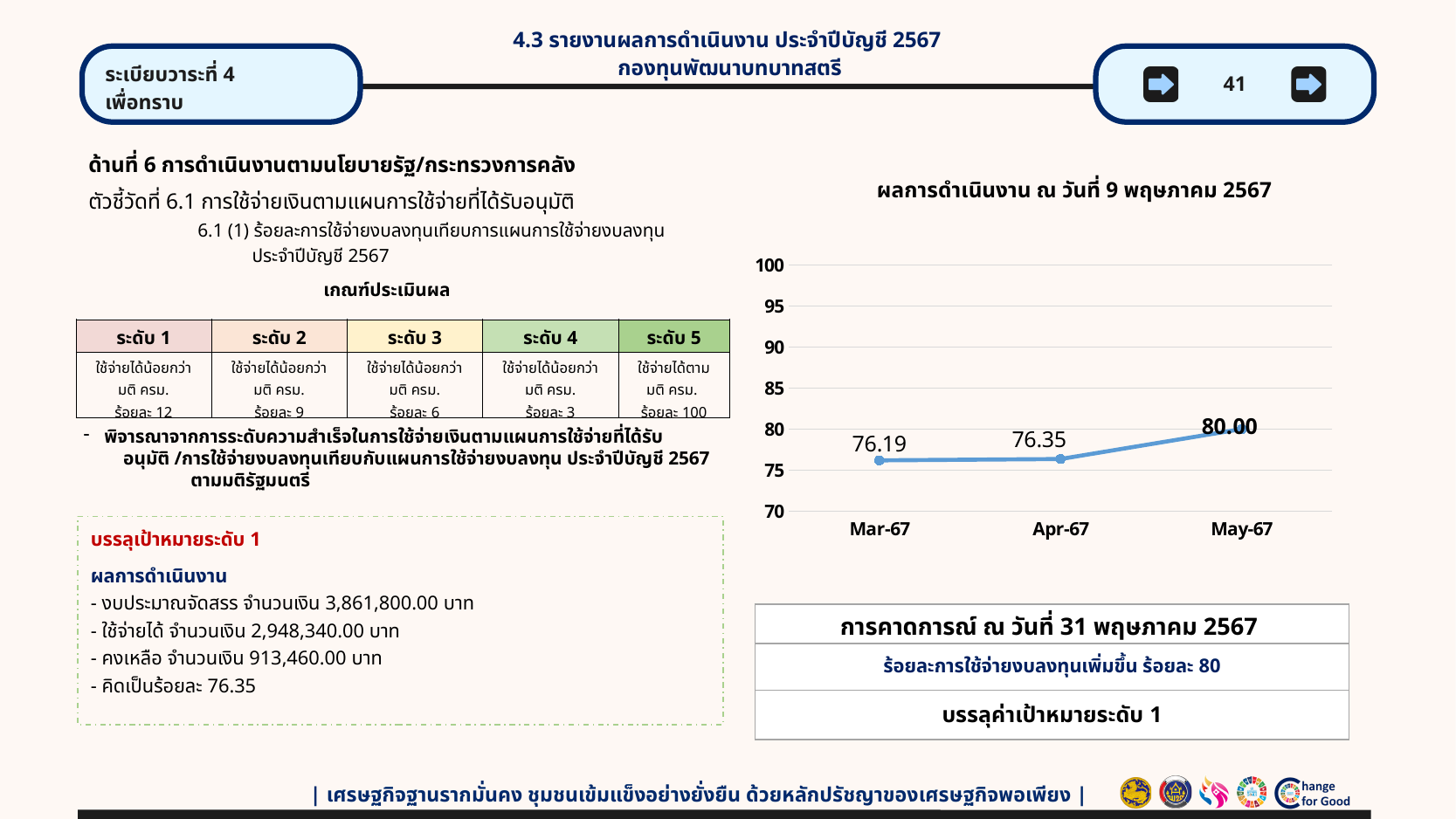
What type of chart is shown on the slide? line chart Is the value for May-67 greater or less than 85? less Which month has the highest value in the line chart? May-67 What is the difference between the values for May-67 and Apr-67? 3.65 Which is larger, the value for May-67 or the value for Mar-67? May-67 What is the difference between the values for Apr-67 and Mar-67? 0.16 How many data points are plotted on the line chart? 3 What is the value for May-67 in the line chart? 80.00 Do the values rise or fall from Mar-67 to May-67 along the x axis? rise What is the value for Apr-67 in the line chart? 76.35 Which month has the lowest value in the line chart? Mar-67 What is the value for Mar-67 in the line chart? 76.19